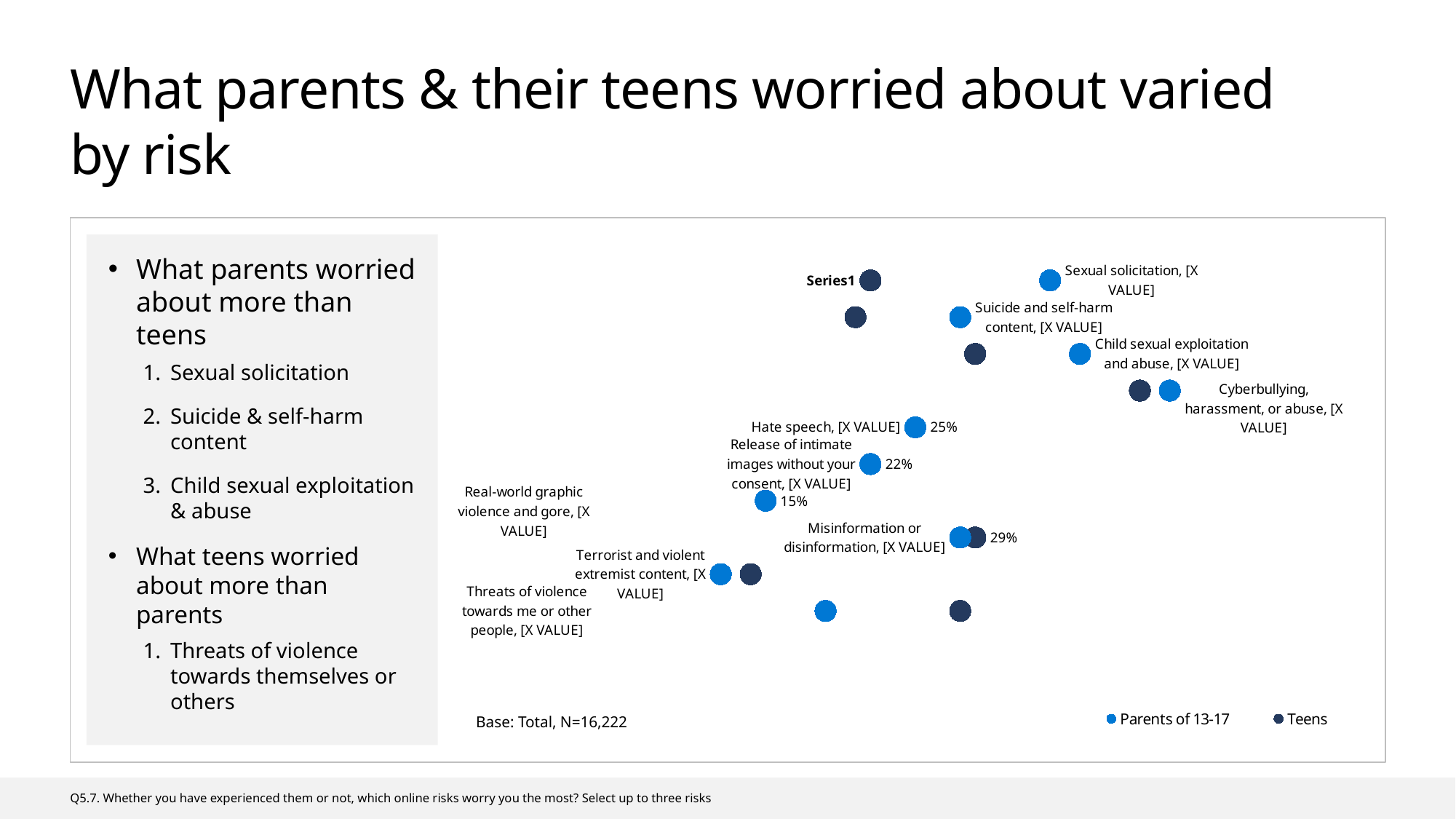
How many series does the legend list? 2 What percentage of parents of 13-17 worried about release of intimate images without your consent? 22% Which risk has the highest value for parents of 13-17? Cyberbullying, harassment, or abuse What kind of chart is shown on the slide? Scatter (dot) chart What percentage of parents of 13-17 worried about real-world graphic violence and gore? 15% For threats of violence towards me or other people, which group has the higher value: parents of 13-17 or teens? Teens What percentage of parents of 13-17 worried about hate speech? 25% For parents of 13-17, which is larger: the value for hate speech or for real-world graphic violence and gore? Hate speech What is the difference between the parents' values for hate speech and release of intimate images without your consent? 3% What is the difference between the parents' values for hate speech and real-world graphic violence and gore? 10% For sexual solicitation, which group has the higher value: parents of 13-17 or teens? Parents of 13-17 What is the base sample size stated on the chart? N=16,222